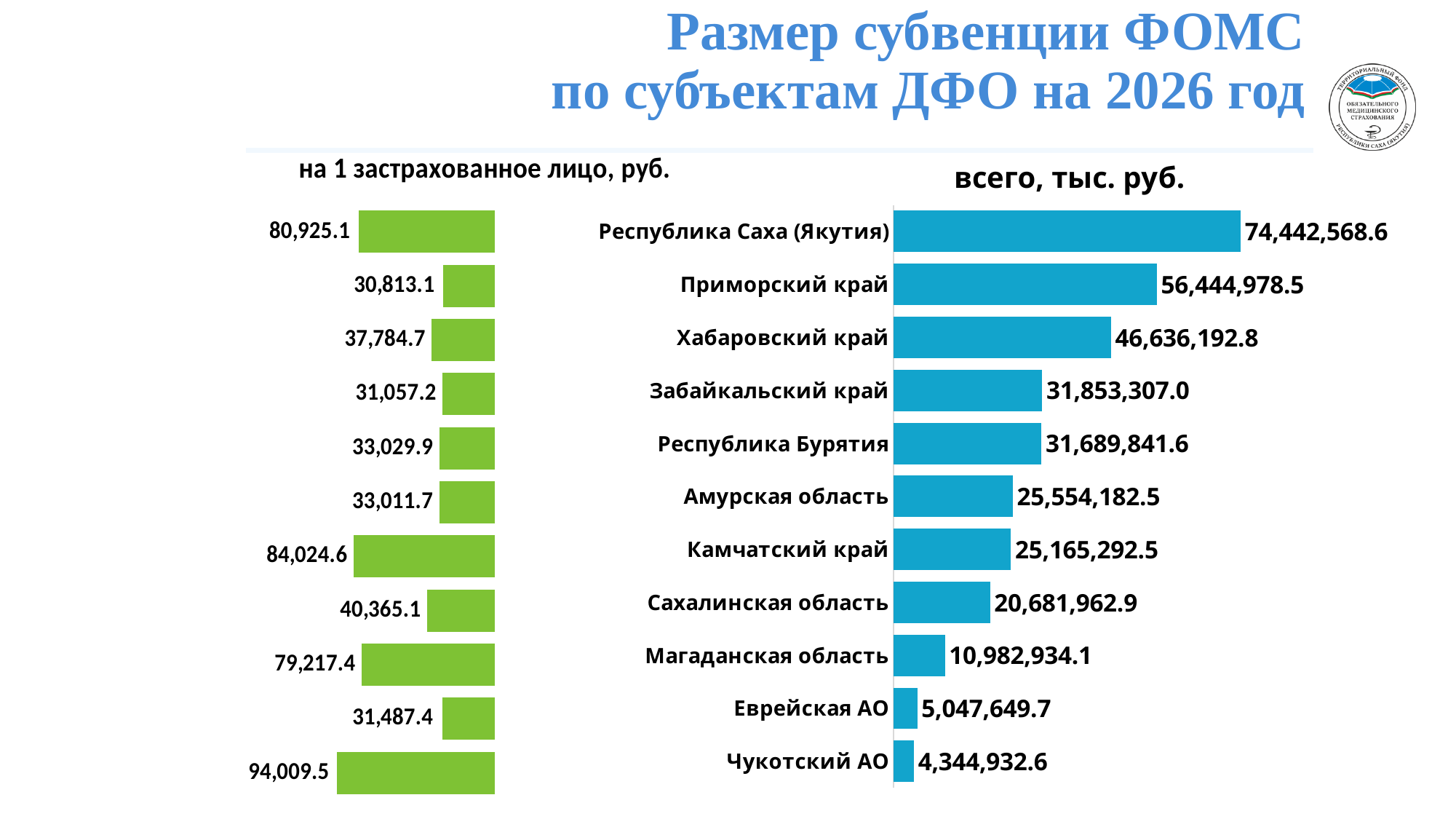
In the chart titled "всего, тыс. руб.", what is the difference between the values for Еврейская АО and Чукотский АО? 702,717.1 In the chart titled "всего, тыс. руб.", what is the value for Приморский край? 56,444,978.5 In the chart titled "всего, тыс. руб.", which is larger: the value for Амурская область or for Камчатский край? Амурская область What kind of chart is the chart titled "всего, тыс. руб."? bar chart In the chart titled "на 1 застрахованное лицо, руб.", what is the value for Чукотский АО (the bottom bar)? 94,009.5 In the chart titled "всего, тыс. руб.", which region has the highest value? Республика Саха (Якутия) In the chart titled "на 1 застрахованное лицо, руб.", which region has the lowest value? Приморский край In the chart titled "всего, тыс. руб.", which region has the lowest value? Чукотский АО In the chart titled "всего, тыс. руб.", how many regions are shown? 11 In the chart titled "на 1 застрахованное лицо, руб.", what is the difference between the values for Камчатский край and Магаданская область? 4,807.2 What is the title of the left chart with green bars? на 1 застрахованное лицо, руб. In the chart titled "всего, тыс. руб.", do the values increase or decrease from the top bar to the bottom bar? decrease